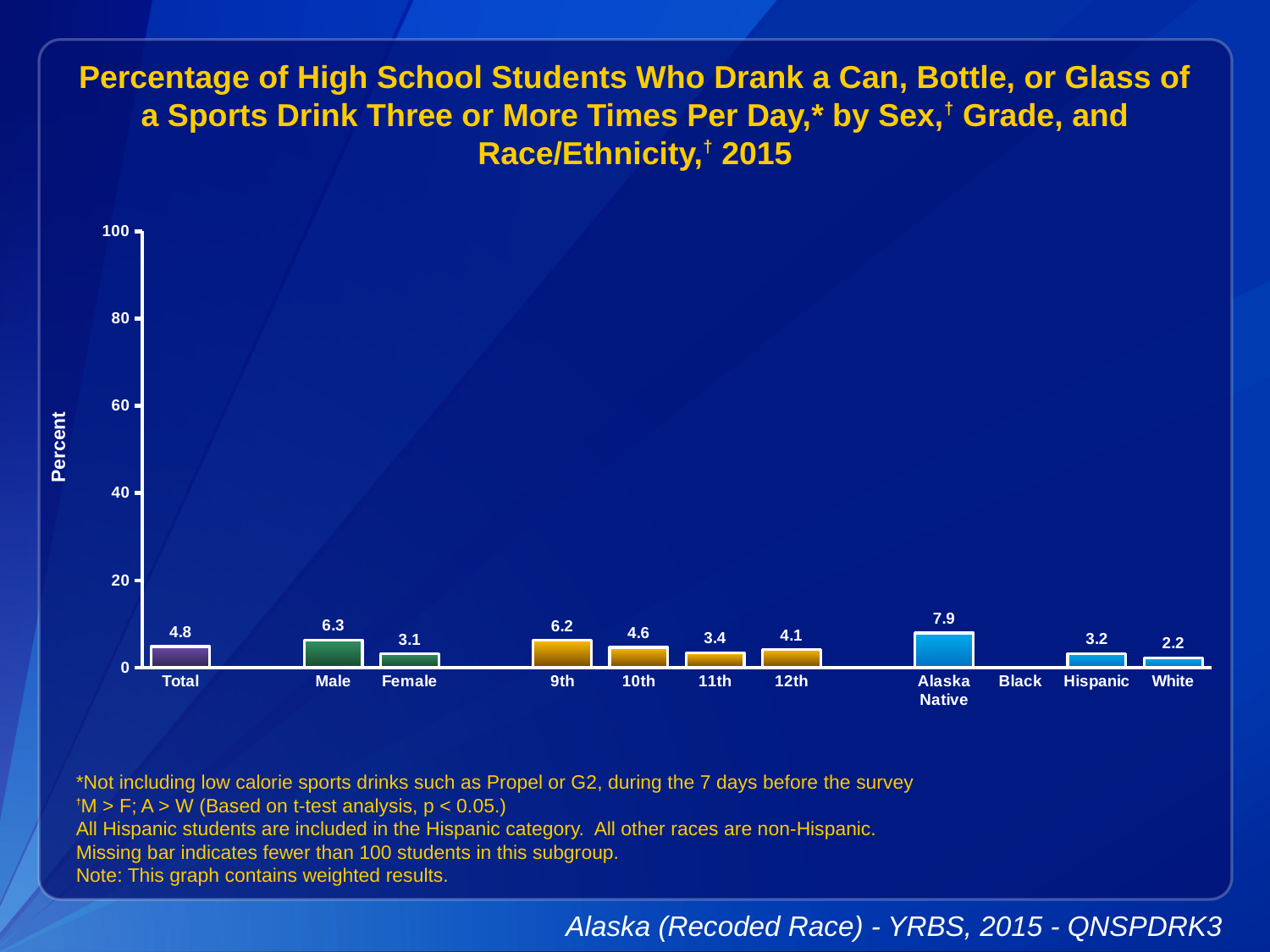
What kind of chart is shown? bar chart Among the categories with a bar shown, which has the lowest value? White Which category has the highest value? Alaska Native Which is larger, the value for 9th grade or 12th grade? 9th What is the value for Alaska Native? 7.9 Which category has no bar shown? Black What is the value for 11th grade? 3.4 What is the difference between the Male and Female values? 3.2 What is the value for Male? 6.3 What is the value for Total? 4.8 Is the value for Hispanic greater or less than 20? less How many categories are labeled on the x axis? 11